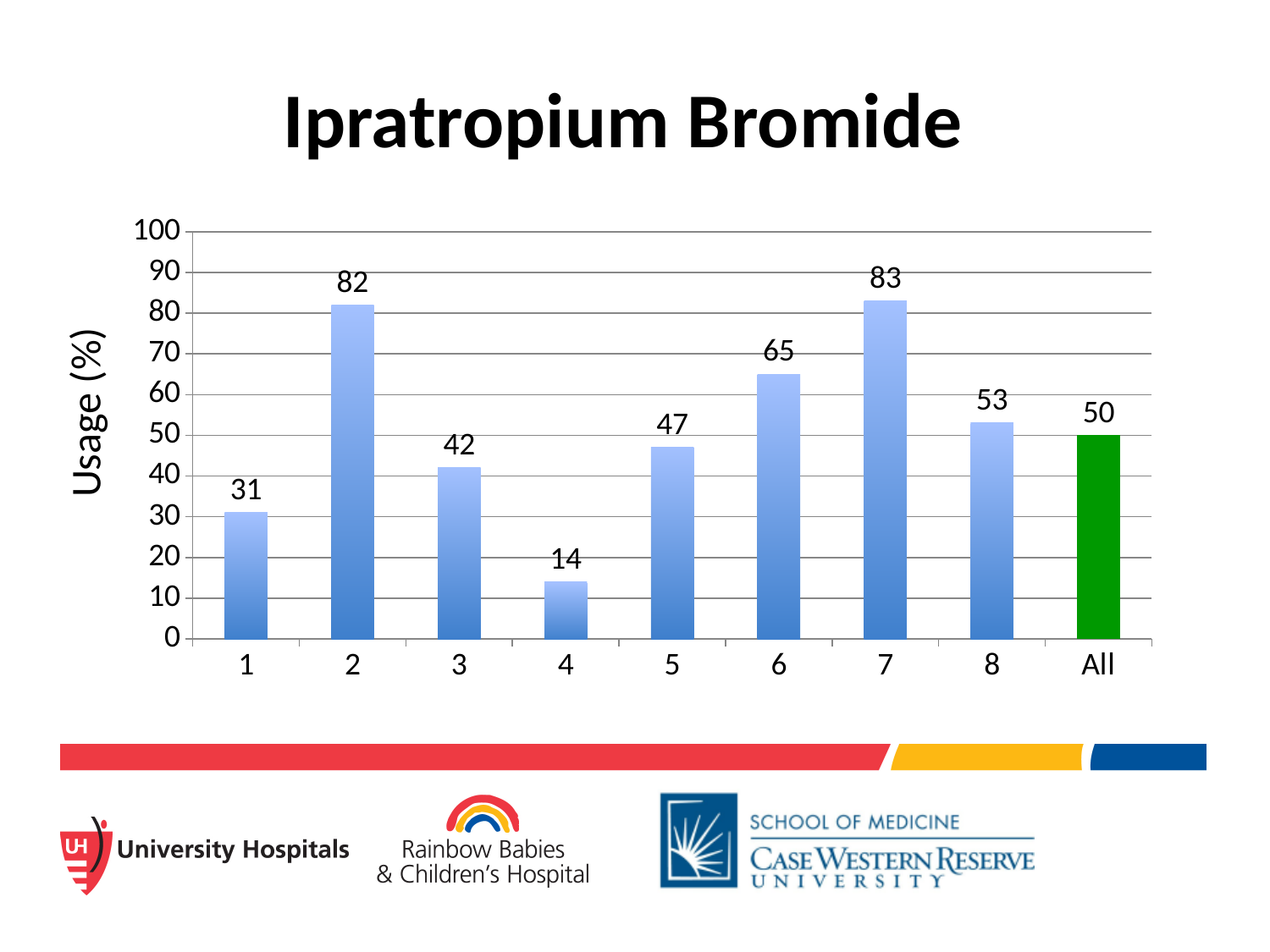
What is the usage (%) for category 2? 82 What kind of chart is shown on the slide? bar chart How many categories are shown on the x axis? 9 Which category has the highest usage? 7 What is the title of the slide? Ipratropium Bromide Which category has the lowest usage? 4 Is the value for category 5 greater or less than 40? greater What is the difference in usage between category 7 and category 1? 52 What is the usage (%) for category 4? 14 Which bar is coloured green? All What is the usage (%) for the 'All' category? 50 Which has higher usage, category 6 or category 8? 6